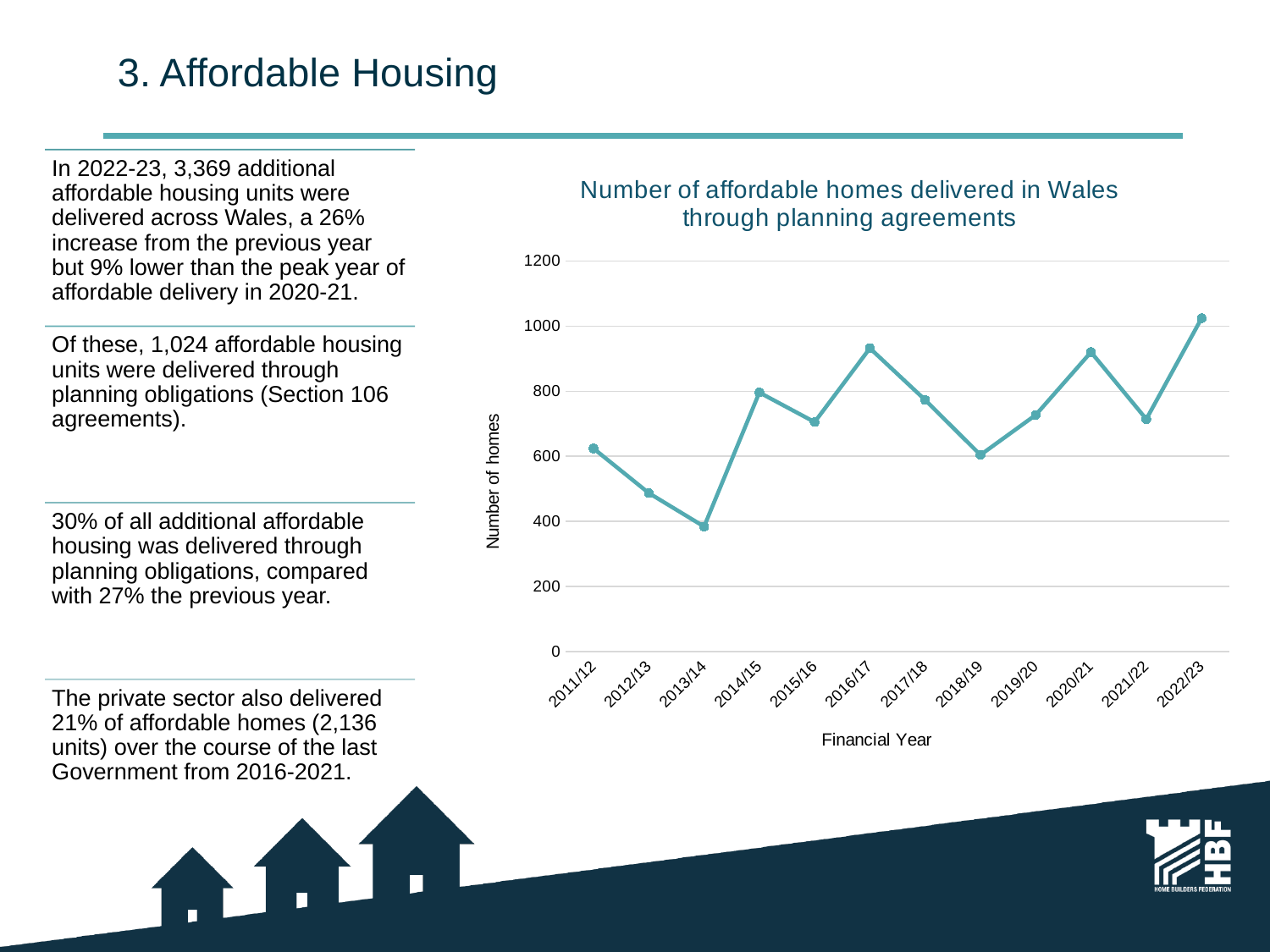
Is the value for 2016/17 greater or less than 800? greater What is the title of the chart? Number of affordable homes delivered in Wales through planning agreements Is the value for 2021/22 greater or less than 800? less Do the values rise or fall from 2011/12 to 2013/14? fall Which is larger, the value for 2014/15 or the value for 2015/16? 2014/15 How many financial years are plotted on the x axis of the chart? 12 Is the value for 2013/14 greater or less than 400? less What kind of chart is shown on the slide? Line chart Which financial year has the lowest number of affordable homes delivered through planning agreements? 2013/14 What is the label on the vertical axis of the chart? Number of homes Which financial year has the highest number of affordable homes delivered through planning agreements? 2022/23